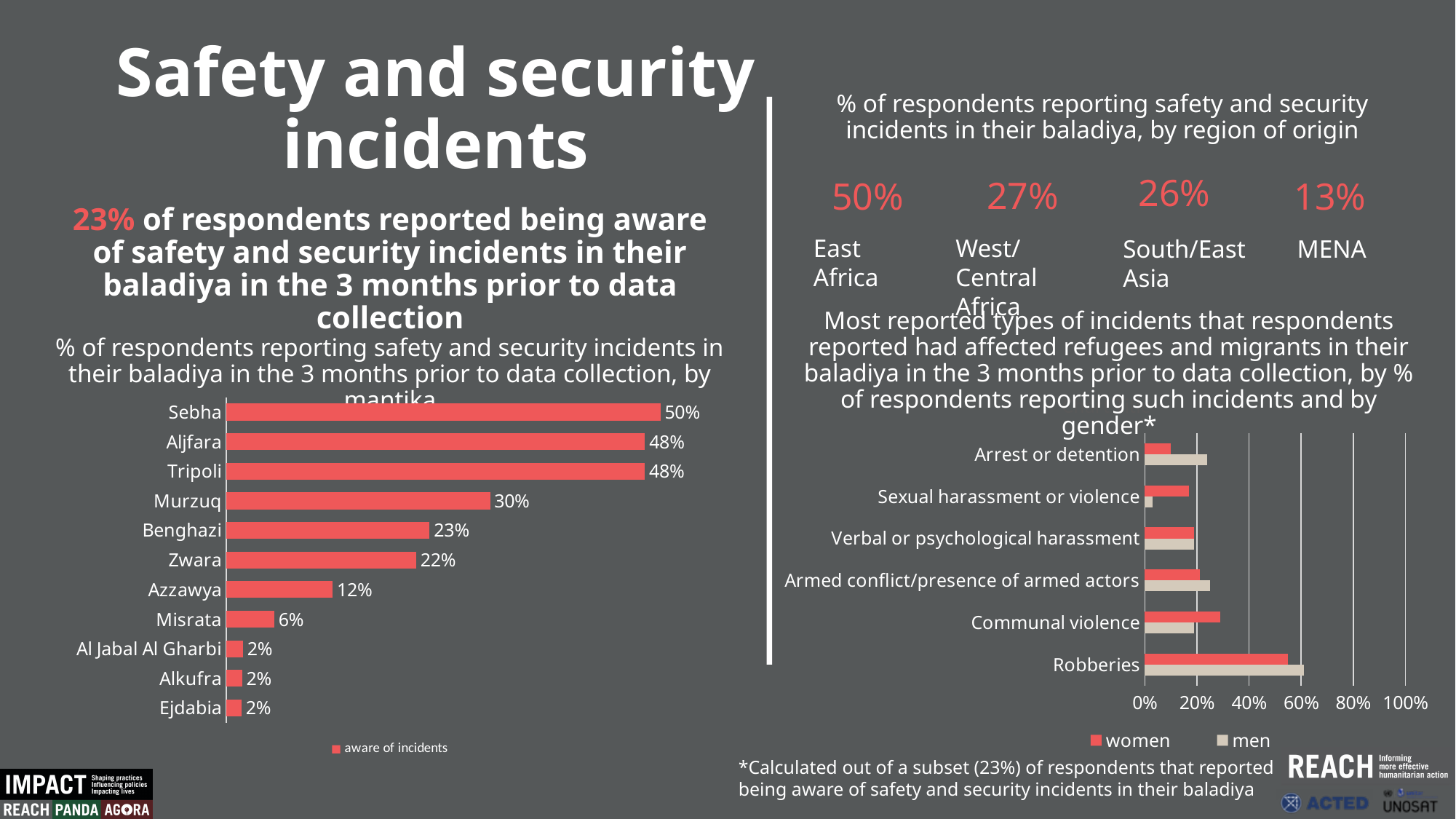
What kind of chart is the chart of most reported types of incidents by gender? bar chart In the chart of respondents reporting safety and security incidents by mantika, how many mantikas are shown? 11 In the chart of respondents reporting safety and security incidents by mantika, what is the value for Murzuq? 30% In the chart of respondents reporting safety and security incidents by mantika, what is the value for Sebha? 50% In the chart of most reported types of incidents by gender, which is larger for Sexual harassment or violence, women or men? women In the chart of respondents reporting safety and security incidents by mantika, which mantika has the highest value? Sebha In the chart of respondents reporting safety and security incidents by mantika, which is larger, Azzawya or Misrata? Azzawya In the chart of respondents reporting safety and security incidents by mantika, what is the legend entry? aware of incidents In the chart of respondents reporting safety and security incidents by mantika, what is the difference between Sebha and Benghazi? 27% In the chart of most reported types of incidents by gender, how many incident types are shown? 6 In the chart of most reported types of incidents by gender, is the value for women for Robberies greater or less than 40%? greater In the chart of most reported types of incidents by gender, how many series does the legend list? 2